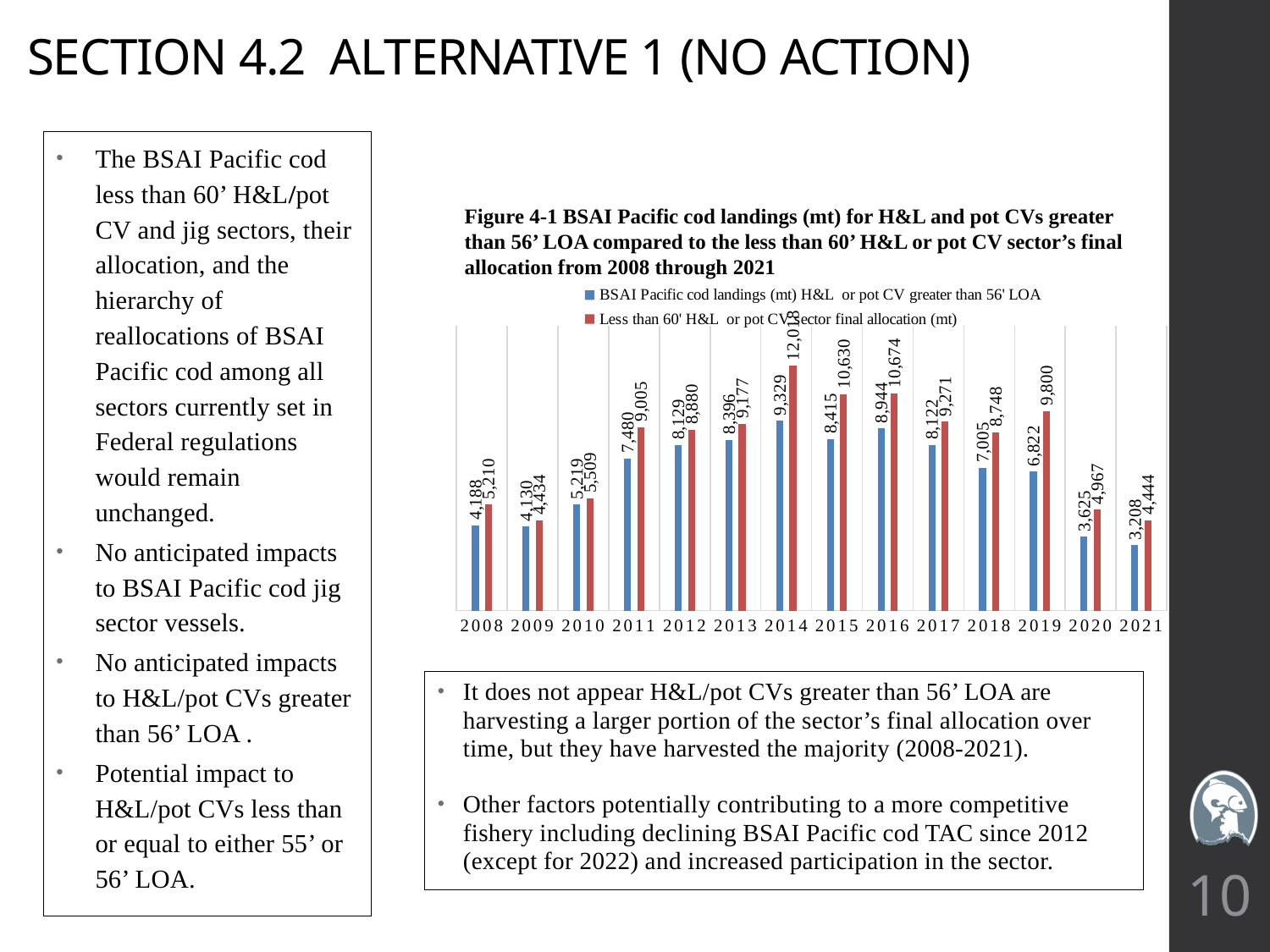
In which year was the less than 60' H&L or pot CV sector final allocation the lowest? 2009 In which year were the landings for H&L or pot CVs greater than 56' LOA the lowest? 2021 What is the difference between the sector final allocation and the landings for CVs greater than 56' LOA in 2021? 1,236 In which year were the landings for H&L or pot CVs greater than 56' LOA the highest? 2014 What kind of chart is shown on the slide? Bar chart How many series does the chart's legend list? 2 Were the landings for H&L or pot CVs greater than 56' LOA larger in 2015 or in 2016? 2016 What were the landings (mt) for H&L or pot CVs greater than 56' LOA in 2021? 3,208 What were the BSAI Pacific cod landings (mt) for H&L or pot CVs greater than 56' LOA in 2014? 9,329 What was the less than 60' H&L or pot CV sector final allocation (mt) in 2019? 9,800 How many years are shown on the x axis of the chart? 14 What is the difference between the sector final allocation and the landings for CVs greater than 56' LOA in 2019? 2,978